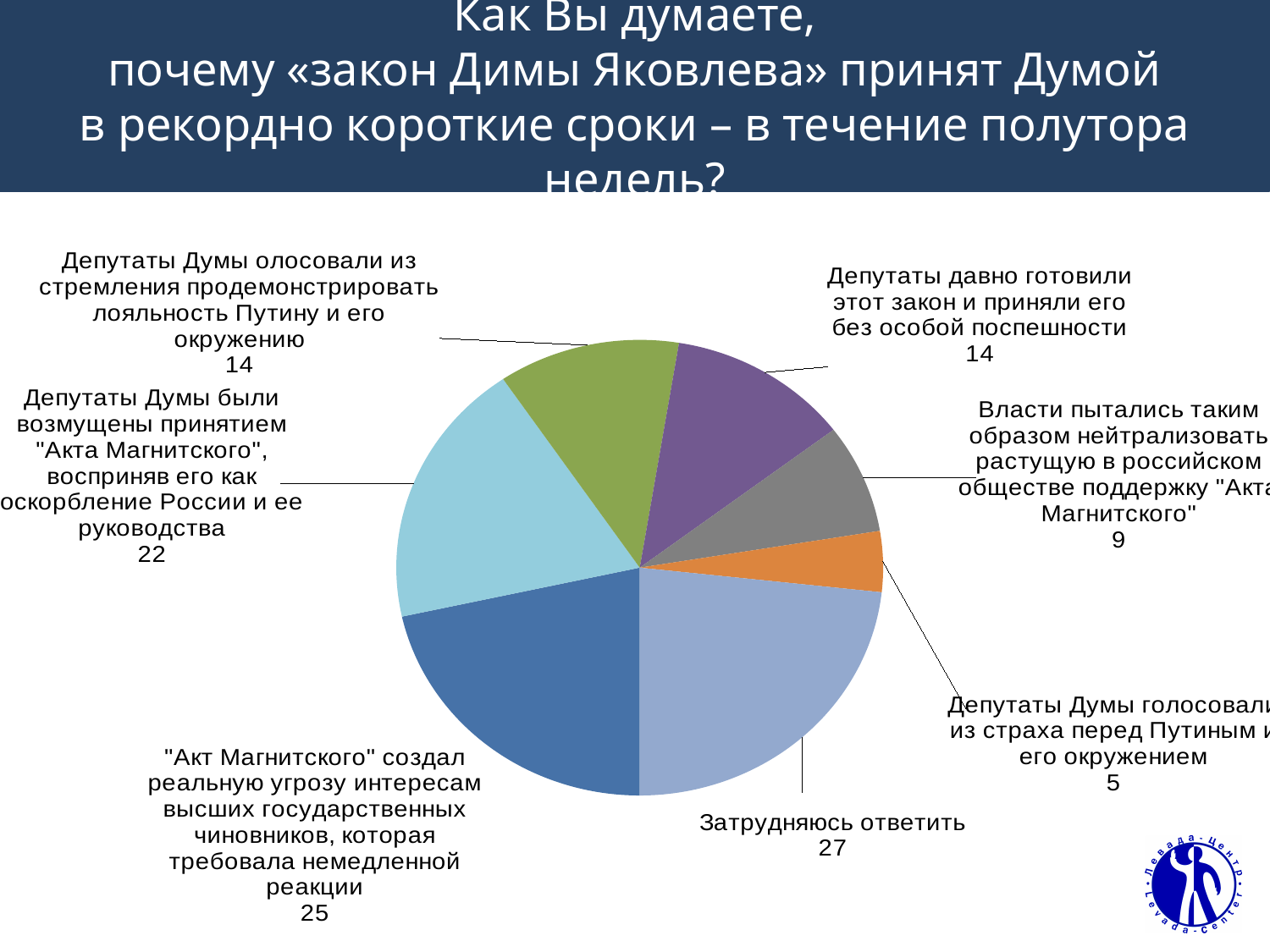
What is the difference between the value for "Депутаты давно готовили этот закон и приняли его без особой поспешности" and the value for "Власти пытались таким образом нейтрализовать растущую в российском обществе поддержку "Акта Магнитского""? 5 What is the value for "Затрудняюсь ответить"? 27 How many slices does the pie chart have? 7 What is the value for "Депутаты Думы голосовали из страха перед Путиным и его окружением"? 5 Which is larger: the value for ""Акт Магнитского" создал реальную угрозу интересам высших государственных чиновников, которая требовала немедленной реакции" or the value for "Депутаты Думы были возмущены принятием "Акта Магнитского", восприняв его как оскорбление России и ее руководства"? "Акт Магнитского" создал реальную угрозу интересам высших государственных чиновников, которая требовала немедленной реакции What is the difference between the value for "Затрудняюсь ответить" and the value for "Депутаты Думы голосовали из страха перед Путиным и его окружением"? 22 What kind of chart is shown on the slide? pie chart Which category has the largest slice of the pie? Затрудняюсь ответить Which category has the smallest slice of the pie? Депутаты Думы голосовали из страха перед Путиным и его окружением What is the value for "Депутаты Думы были возмущены принятием "Акта Магнитского", восприняв его как оскорбление России и ее руководства"? 22 What is the value for "Власти пытались таким образом нейтрализовать растущую в российском обществе поддержку "Акта Магнитского""? 9 What colour is the slice for "Затрудняюсь ответить"? light blue